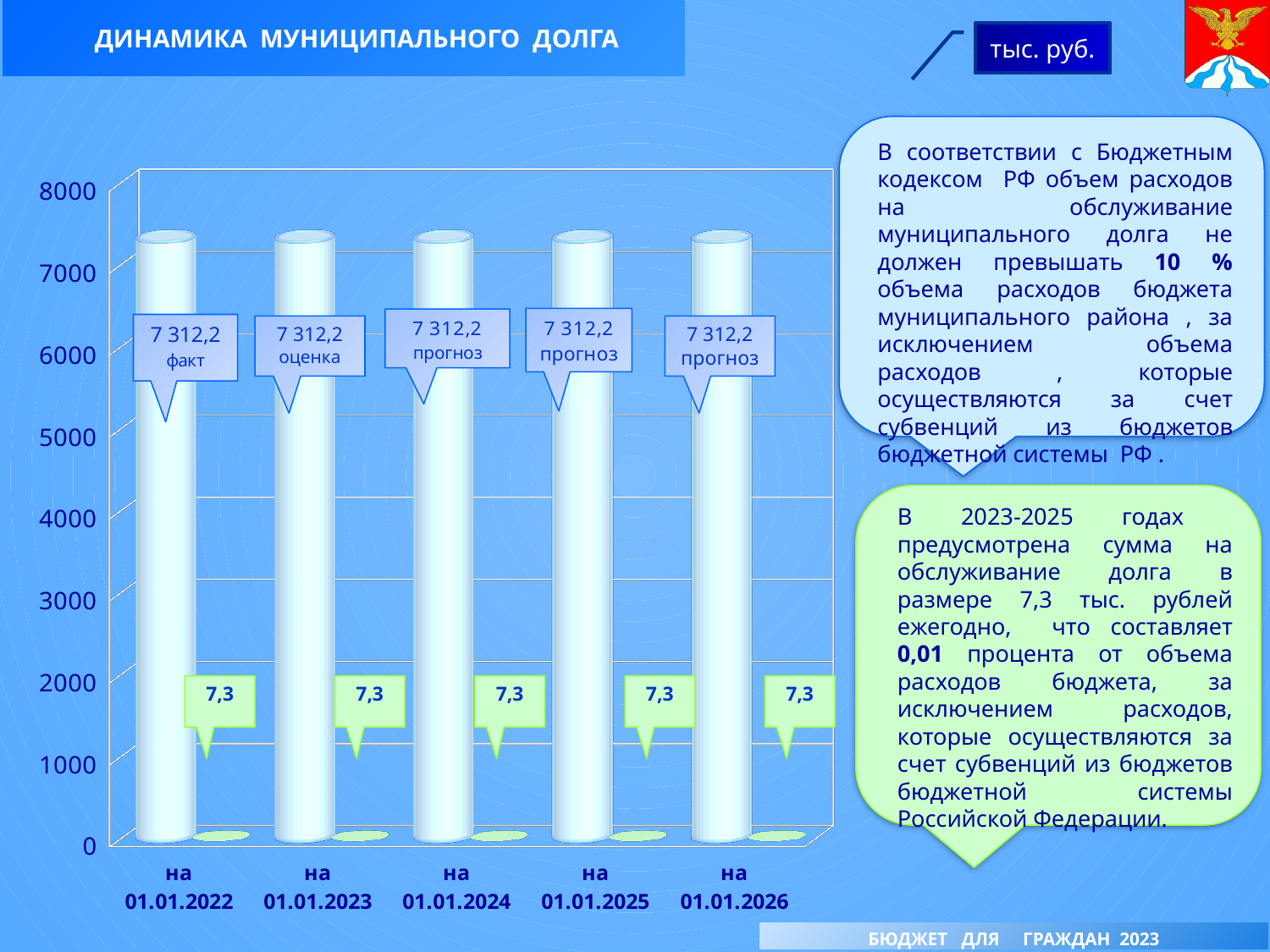
What label accompanies the value 7 312,2 for на 01.01.2023? оценка How many dates (categories) are shown on the x axis of the chart? 5 What is the municipal debt value shown for на 01.01.2022? 7 312,2 What is the difference between the municipal debt values for на 01.01.2025 and на 01.01.2022? 0 What kind of chart is used on the slide? bar chart What is the debt servicing value (green label) shown for на 01.01.2024? 7,3 Do the municipal debt values rise, fall or stay the same from 01.01.2022 to 01.01.2026? stay the same In what units are the chart values given, according to the slide? тыс. руб. Is the municipal debt value for на 01.01.2024 greater or less than 7000? greater What is the title of the chart? ДИНАМИКА МУНИЦИПАЛЬНОГО ДОЛГА What label accompanies the value 7 312,2 for на 01.01.2022? факт What is the municipal debt value shown for на 01.01.2026? 7 312,2